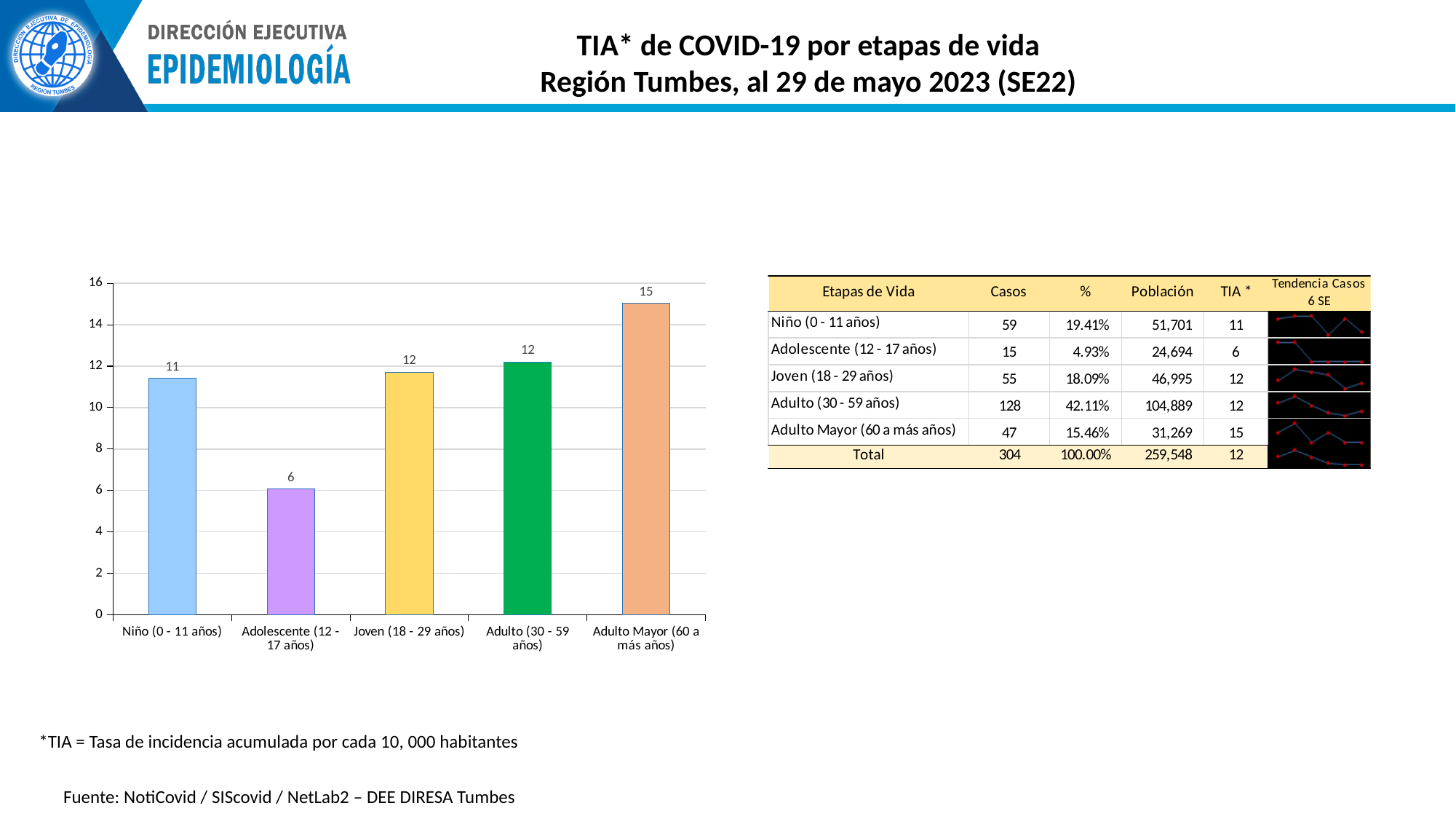
What is the TIA value shown for Adolescente (12 - 17 años) in the bar chart? 6 What is the TIA value shown for Joven (18 - 29 años) in the bar chart? 12 What colour is the bar for Joven (18 - 29 años)? Yellow Which life stage has the lowest TIA in the bar chart? Adolescente (12 - 17 años) Which has a higher TIA, Niño (0 - 11 años) or Adulto (30 - 59 años)? Adulto (30 - 59 años) How many life-stage categories are shown in the bar chart? 5 What is the TIA value shown for Adulto Mayor (60 a más años) in the bar chart? 15 What is the TIA value shown for Niño (0 - 11 años) in the bar chart? 11 Which life stage has the highest TIA in the bar chart? Adulto Mayor (60 a más años) What kind of chart is used to show TIA by life stage? Bar chart What is the difference between the TIA for Adulto Mayor (60 a más años) and Adolescente (12 - 17 años)? 9 Is the TIA value for Adulto Mayor (60 a más años) greater or less than 14? greater